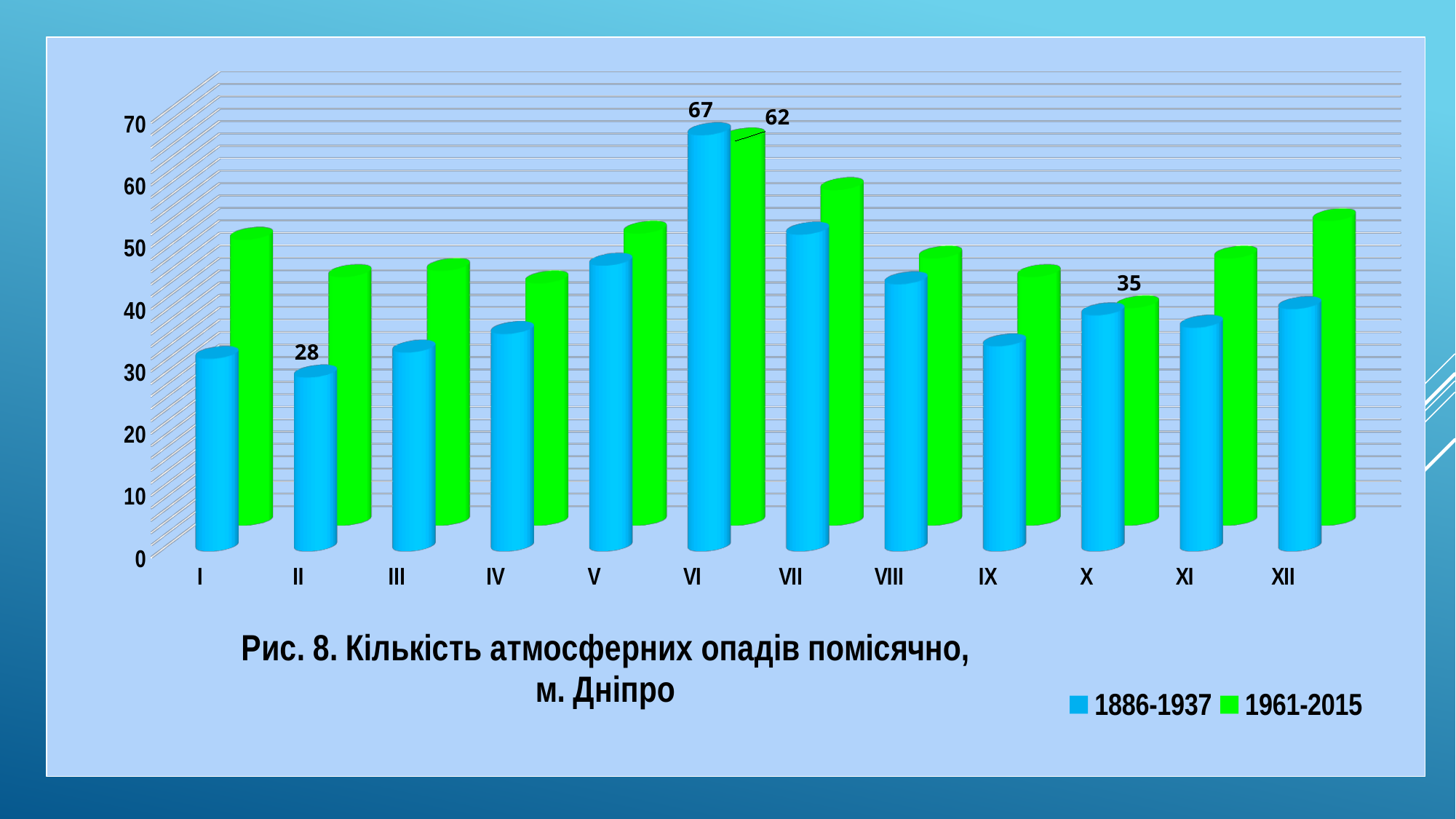
Is the value for month I in the 1886-1937 series greater or less than 40? less What is the value for month X in the 1961-2015 series? 35 What is the difference between the 1886-1937 and 1961-2015 values for month VI? 5 What is the value for month II in the 1886-1937 series? 28 What is the value for month VI in the 1886-1937 series? 67 What is the value for month VI in the 1961-2015 series? 62 For month I, which series has the larger value, 1886-1937 or 1961-2015? 1961-2015 What kind of chart is shown on the slide? bar chart Which month has the lowest value in the 1886-1937 series? II How many series does the legend list? 2 How many months (categories) are shown on the x axis? 12 Which month has the highest value in the 1886-1937 series? VI